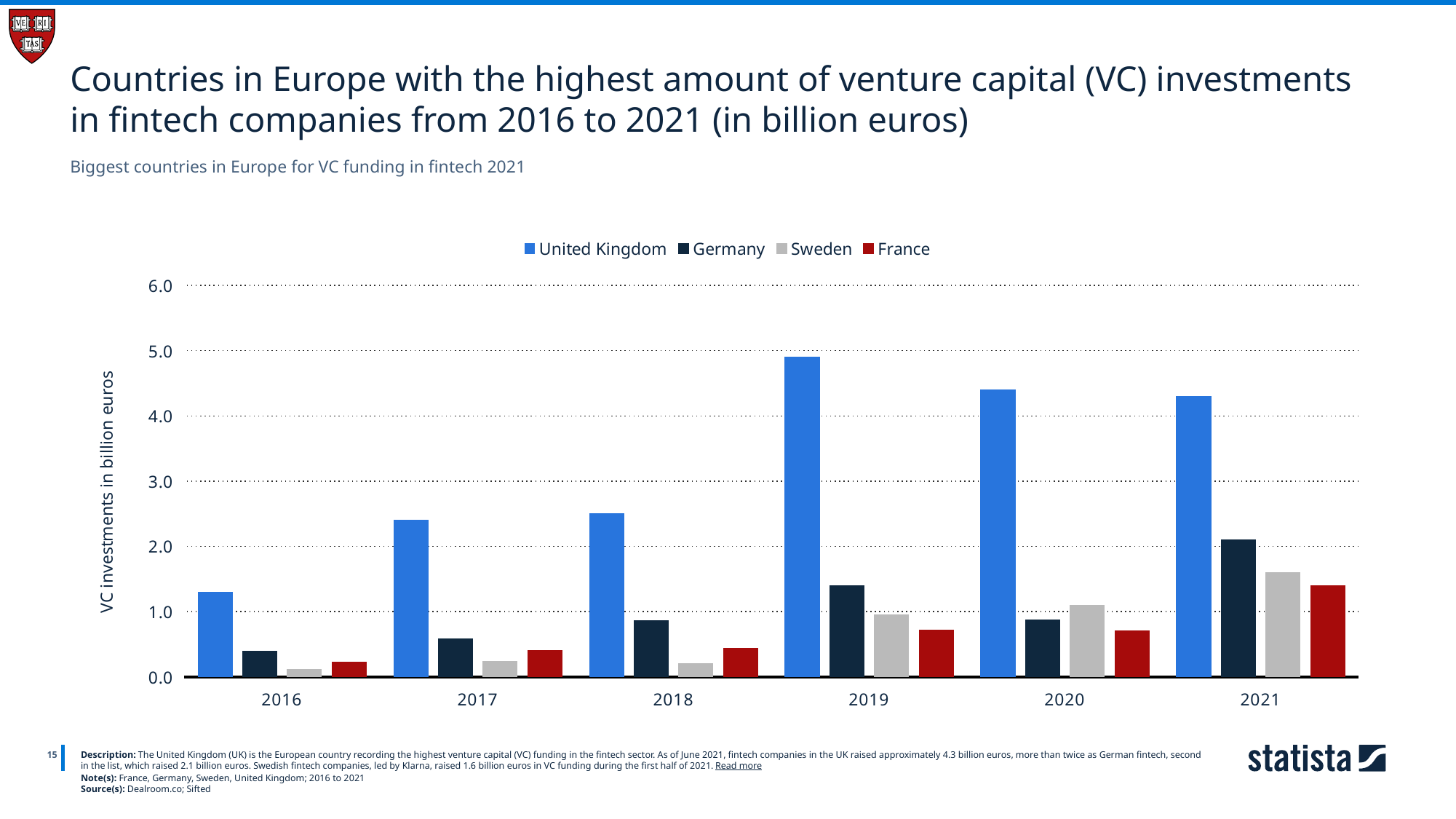
In which year is the United Kingdom bar the highest? 2019 Is the value for the United Kingdom in 2017 greater or less than 2.0? greater Is the value for the United Kingdom in 2019 greater or less than 4.0? greater In 2018, which is larger: the value for Germany or the value for France? Germany How many years are shown on the x axis? 6 How many series does the legend list? 4 Does the United Kingdom value rise or fall from 2016 to 2017? rise What kind of chart is shown on the slide? bar chart Is the value for Germany in 2017 greater or less than 1.0? less Which country has the lowest bar in 2016? Sweden What is the label on the y axis? VC investments in billion euros